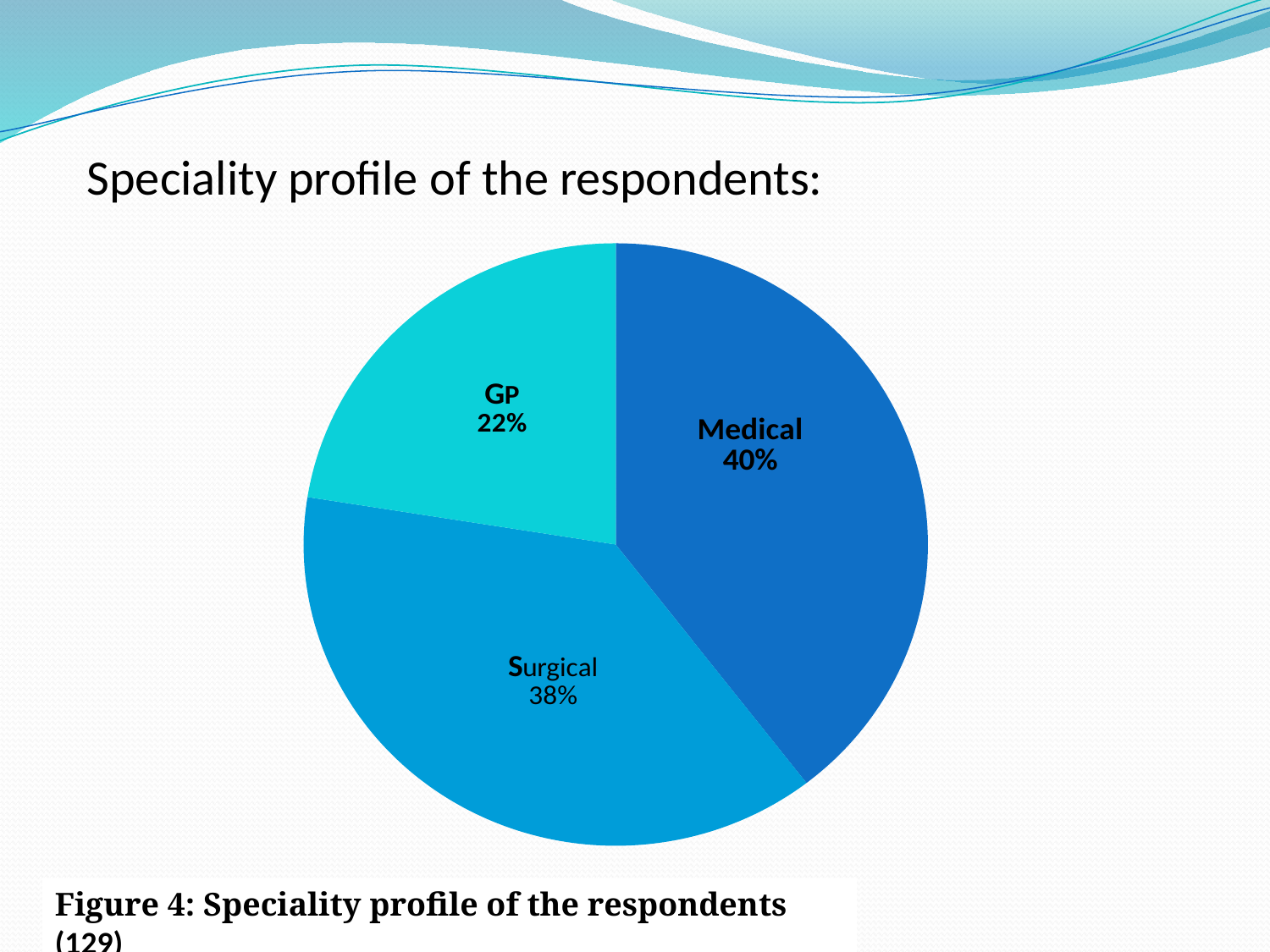
What is the difference in percentage points between the Surgical and GP shares? 16 Which speciality has the largest share of respondents? Medical Which speciality has the smallest share of respondents? GP How many slices does the pie chart have? 3 What is the difference in percentage points between the Medical and GP shares? 18 What share of respondents are in the Surgical speciality? 38% What is the title of the slide? Speciality profile of the respondents: What share of respondents are GPs? 22% According to the figure caption, how many respondents are represented in the chart? 129 What kind of chart is shown on the slide? pie chart Which is larger, the Surgical share or the GP share? Surgical What share of respondents are in the Medical speciality? 40%